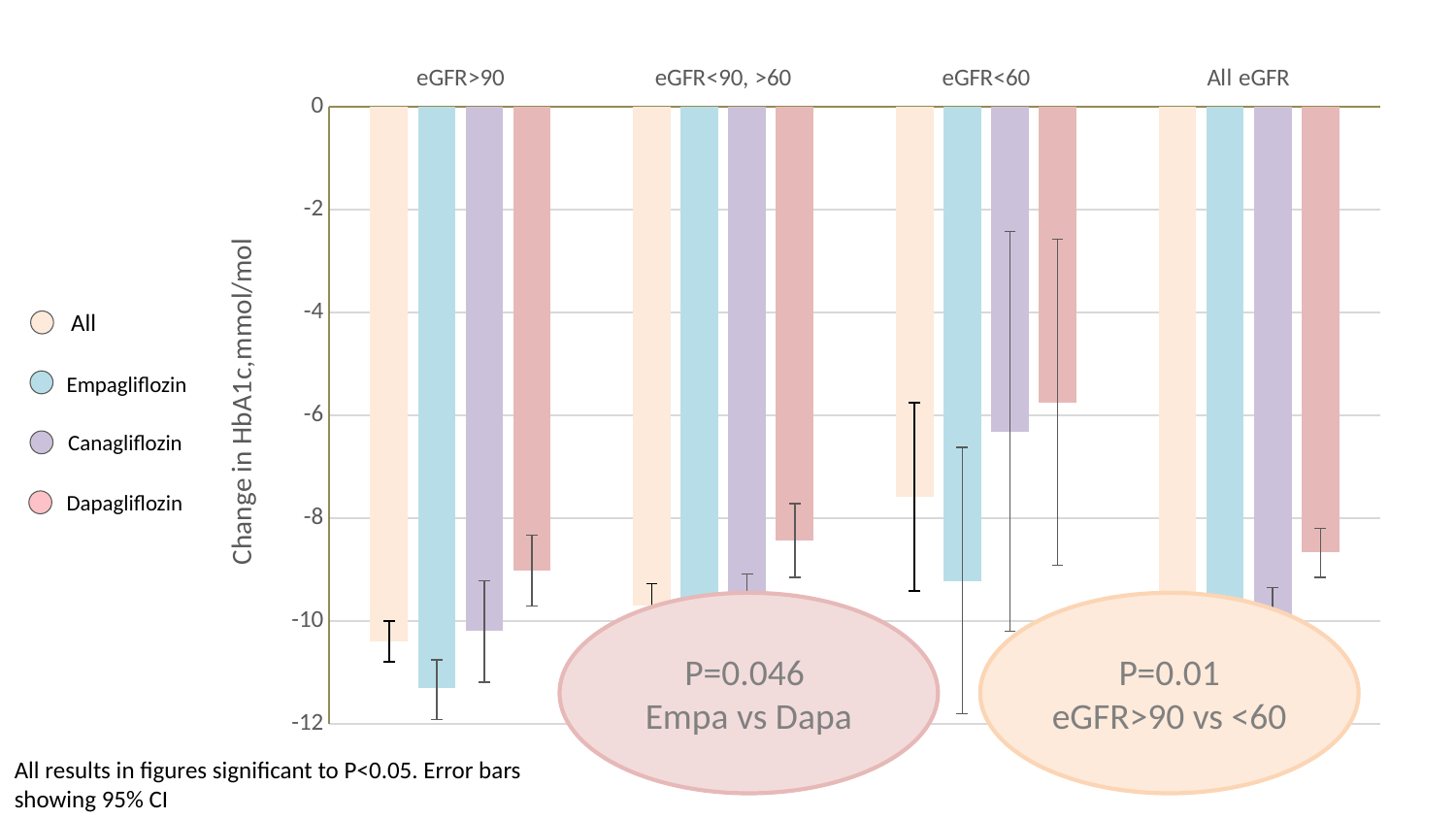
Is the value for Dapagliflozin in the eGFR<60 group greater or less than -4? less What P value is given for the comparison of Empa vs Dapa? P=0.046 How many series does the legend list? 4 In the eGFR<60 group, which shows a larger reduction in HbA1c, Empagliflozin or Dapagliflozin? Empagliflozin Is the value for Canagliflozin in the eGFR<60 group greater or less than -8? greater Is the value for Canagliflozin in the eGFR>90 group greater or less than -8? less What is the label of the y axis? Change in HbA1c, mmol/mol Which drug shows the smallest reduction in HbA1c in the eGFR<60 group? Dapagliflozin Which drug shows the largest reduction in HbA1c in the eGFR>90 group? Empagliflozin How many eGFR groups are shown along the x axis? 4 What kind of chart is shown on the slide? bar chart